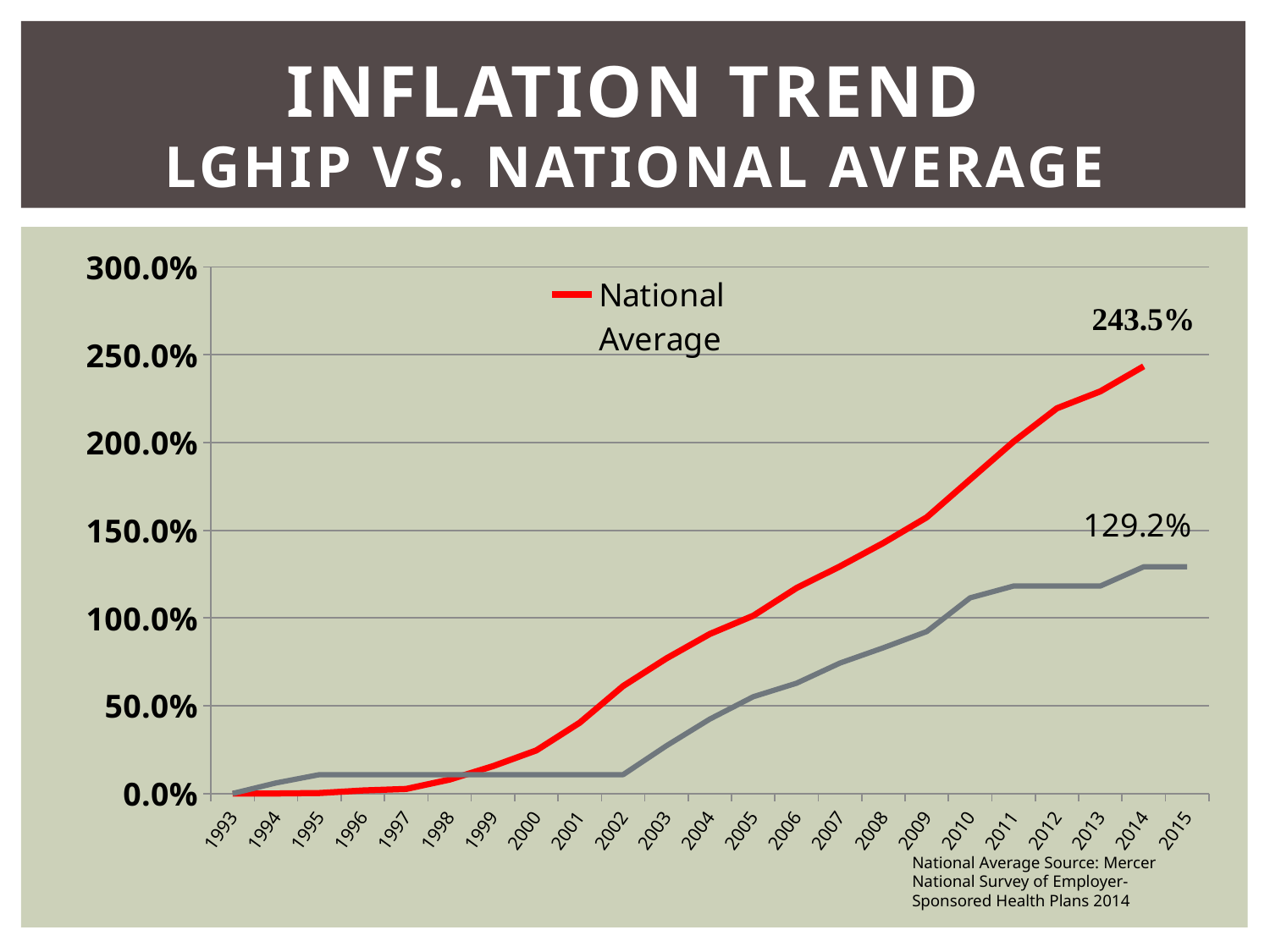
What is the difference between the two end-point labels, 243.5% and 129.2%? 114.3% Is the National Average value for 2010 greater or less than 150.0%? greater How many series does the legend list? 1 Do the values of the National Average line rise or fall from 1993 to 2014? rise Is the National Average value for 2008 greater or less than 150.0%? less How many years are shown on the x axis? 23 What is the final labelled value of the gray (LGHIP) line? 129.2% What is the final labelled value of the National Average line? 243.5% Which line ends at a higher value, the National Average line or the gray LGHIP line? National Average What kind of chart is shown on the slide? line chart Is the gray LGHIP line's value for 2009 greater or less than 100.0%? less What colour is the National Average line? red